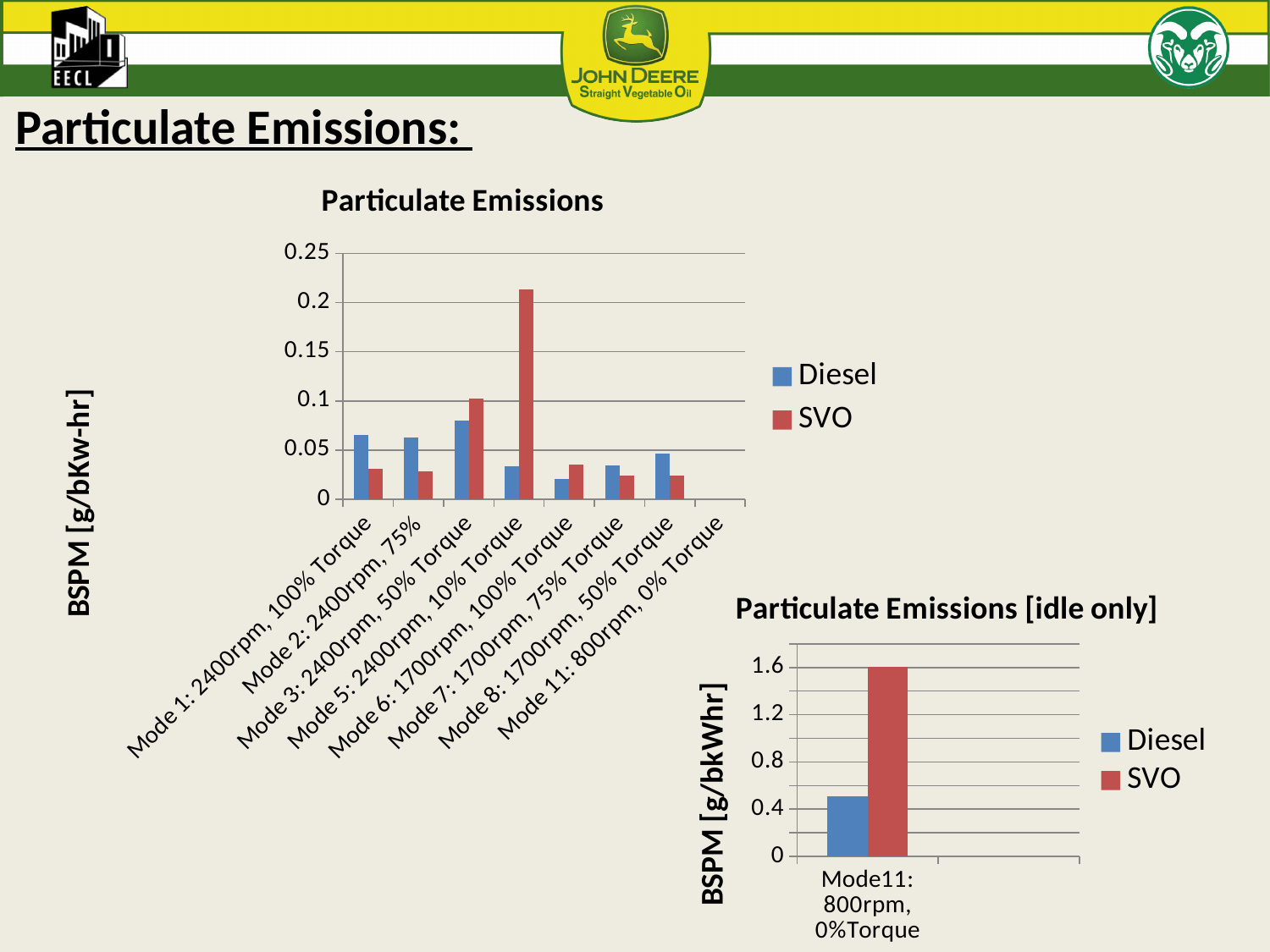
In the 'Particulate Emissions' chart, which category has the lowest Diesel value? Mode 6: 1700rpm, 100% Torque In the 'Particulate Emissions' chart, which category has the highest SVO value? Mode 5: 2400rpm, 10% Torque In the 'Particulate Emissions' chart, which category has the highest Diesel value? Mode 3: 2400rpm, 50% Torque In the 'Particulate Emissions [idle only]' chart, is the SVO value greater or less than 1.2? greater In the 'Particulate Emissions' chart, is the Diesel value for Mode 3: 2400rpm, 50% Torque greater or less than 0.1? less In the 'Particulate Emissions [idle only]' chart, which series has the larger value, Diesel or SVO? SVO In the 'Particulate Emissions' chart, how many series does the legend list? 2 In the 'Particulate Emissions' chart, what kind of chart is shown? bar chart In the 'Particulate Emissions' chart, for Mode 1: 2400rpm, 100% Torque, which series has the larger value, Diesel or SVO? Diesel In the 'Particulate Emissions [idle only]' chart, what is the label on the vertical axis? BSPM [g/bkWhr] In the 'Particulate Emissions' chart, how many category labels appear on the x axis? 8 In the 'Particulate Emissions' chart, is the SVO value for Mode 5: 2400rpm, 10% Torque greater or less than 0.2? greater